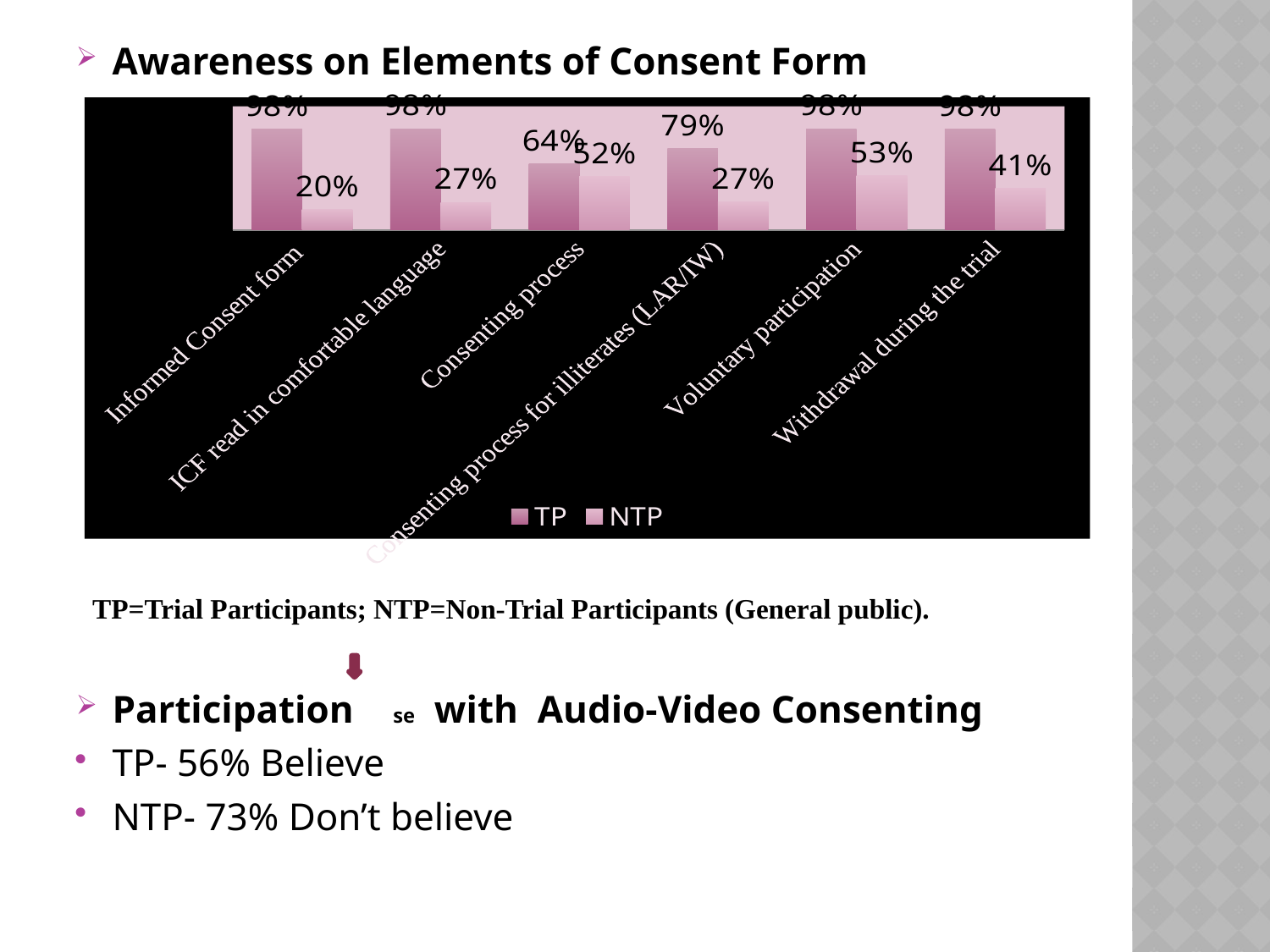
What is the difference between the TP and NTP values for Consenting process for illiterates (LAR/IW)? 52% What is the NTP value for Withdrawal during the trial? 41% What is the TP value for Consenting process for illiterates (LAR/IW)? 79% What kind of chart is shown on the slide? bar chart What is the TP value for Consenting process? 64% What is the NTP value for Voluntary participation? 53% Which category has the lowest NTP value? Informed Consent form Which is larger for Consenting process: the TP value or the NTP value? TP What is the NTP value for Informed Consent form? 20% Which category has the lowest TP value? Consenting process How many series does the chart legend list? 2 How many categories are shown on the x axis of the chart? 6